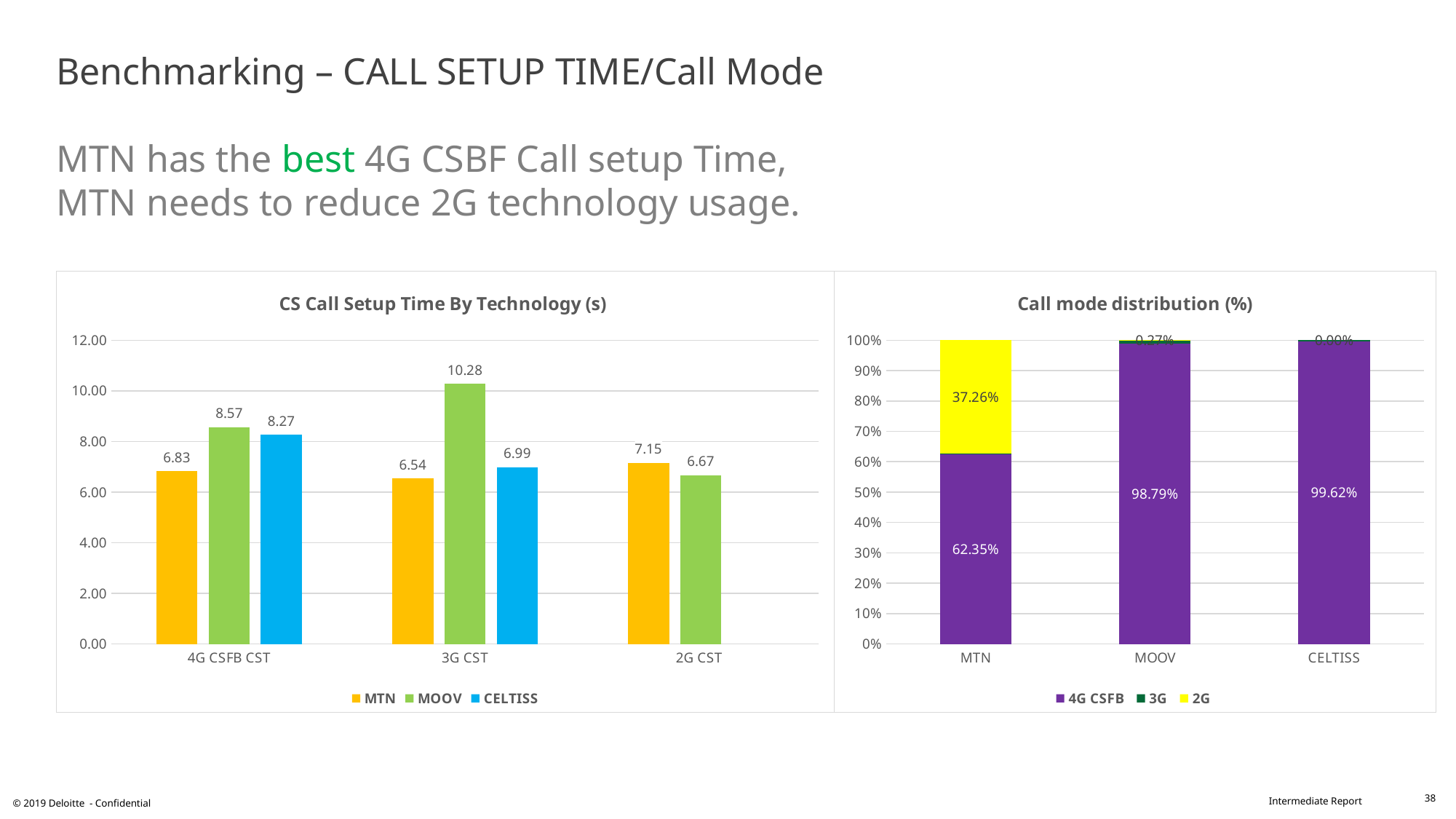
In the 'CS Call Setup Time By Technology (s)' chart, which operator has the lowest call setup time at 4G CSFB CST? MTN In the 'CS Call Setup Time By Technology (s)' chart, what is the value for MTN at 4G CSFB CST? 6.83 What kind of chart is the 'Call mode distribution (%)' chart? Stacked bar chart In the 'Call mode distribution (%)' chart, what is the 2G share for MTN? 37.26% In the 'CS Call Setup Time By Technology (s)' chart, what is the value for CELTISS at 4G CSFB CST? 8.27 How many series does the legend of the 'CS Call Setup Time By Technology (s)' chart list? 3 In the 'CS Call Setup Time By Technology (s)' chart, what is the difference between MOOV and MTN at 3G CST? 3.74 In the 'CS Call Setup Time By Technology (s)' chart, which is larger at 2G CST: MTN or MOOV? MTN In the 'CS Call Setup Time By Technology (s)' chart, what is the value for MOOV at 3G CST? 10.28 In the 'CS Call Setup Time By Technology (s)' chart, which operator has the highest call setup time at 3G CST? MOOV In the 'Call mode distribution (%)' chart, what is the 4G CSFB share for MTN? 62.35% In the 'Call mode distribution (%)' chart, which operator has the highest 4G CSFB share? CELTISS